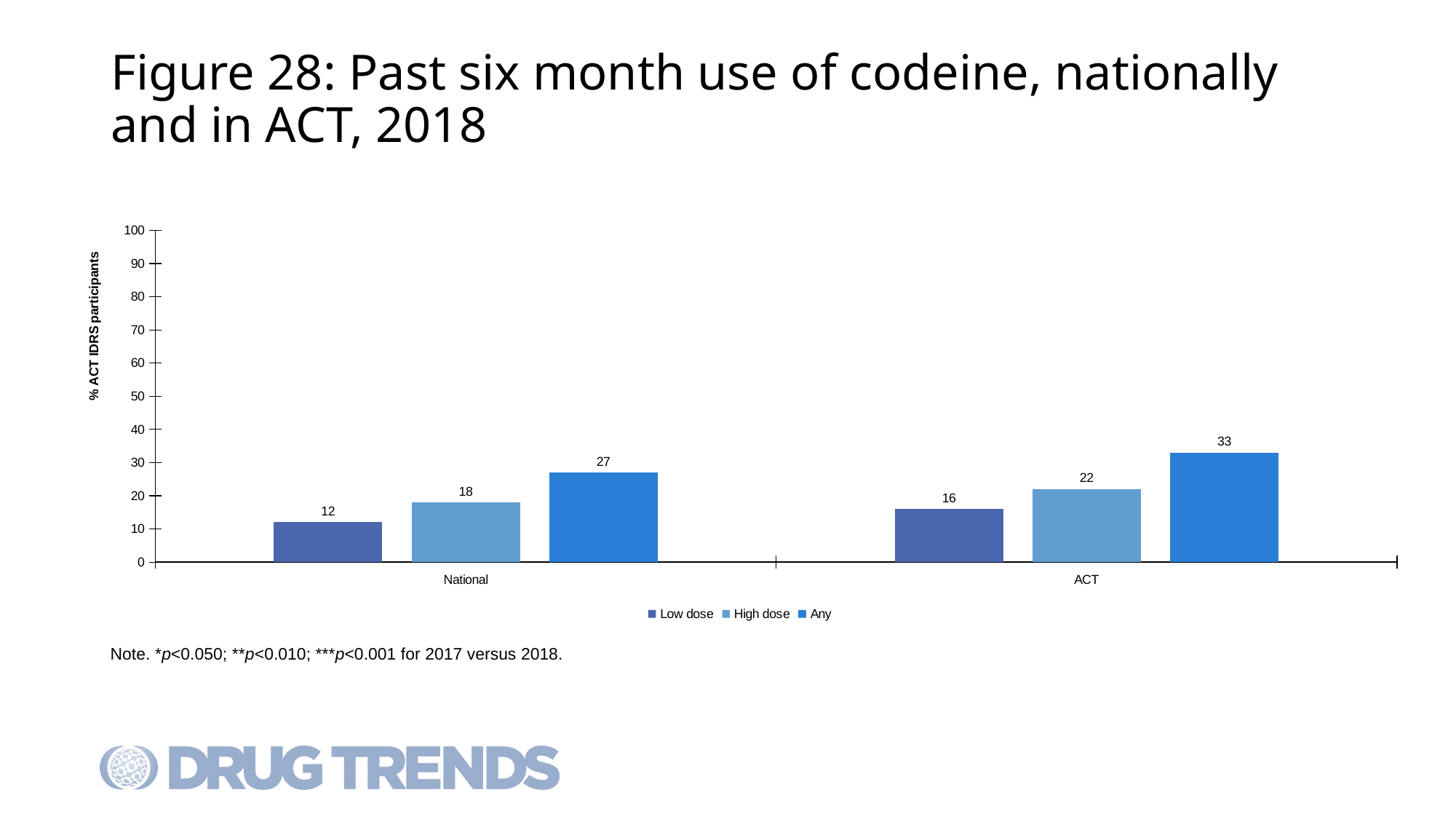
What is the difference between the Any value for ACT and the Any value for National? 6 Which series has the highest value in the National group? Any How many categories are shown on the x axis? 2 What is the label of the y axis? % ACT IDRS participants What kind of chart is shown on the slide? Bar chart Is the value for Any in the ACT group greater or less than 30? greater Which series has the lowest value in the ACT group? Low dose What is the value for High dose in the ACT group? 22 What is the value for Any in the ACT group? 33 How many series does the legend list? 3 What is the value for Low dose in the National group? 12 Which is larger: High dose for National or High dose for ACT? High dose for ACT